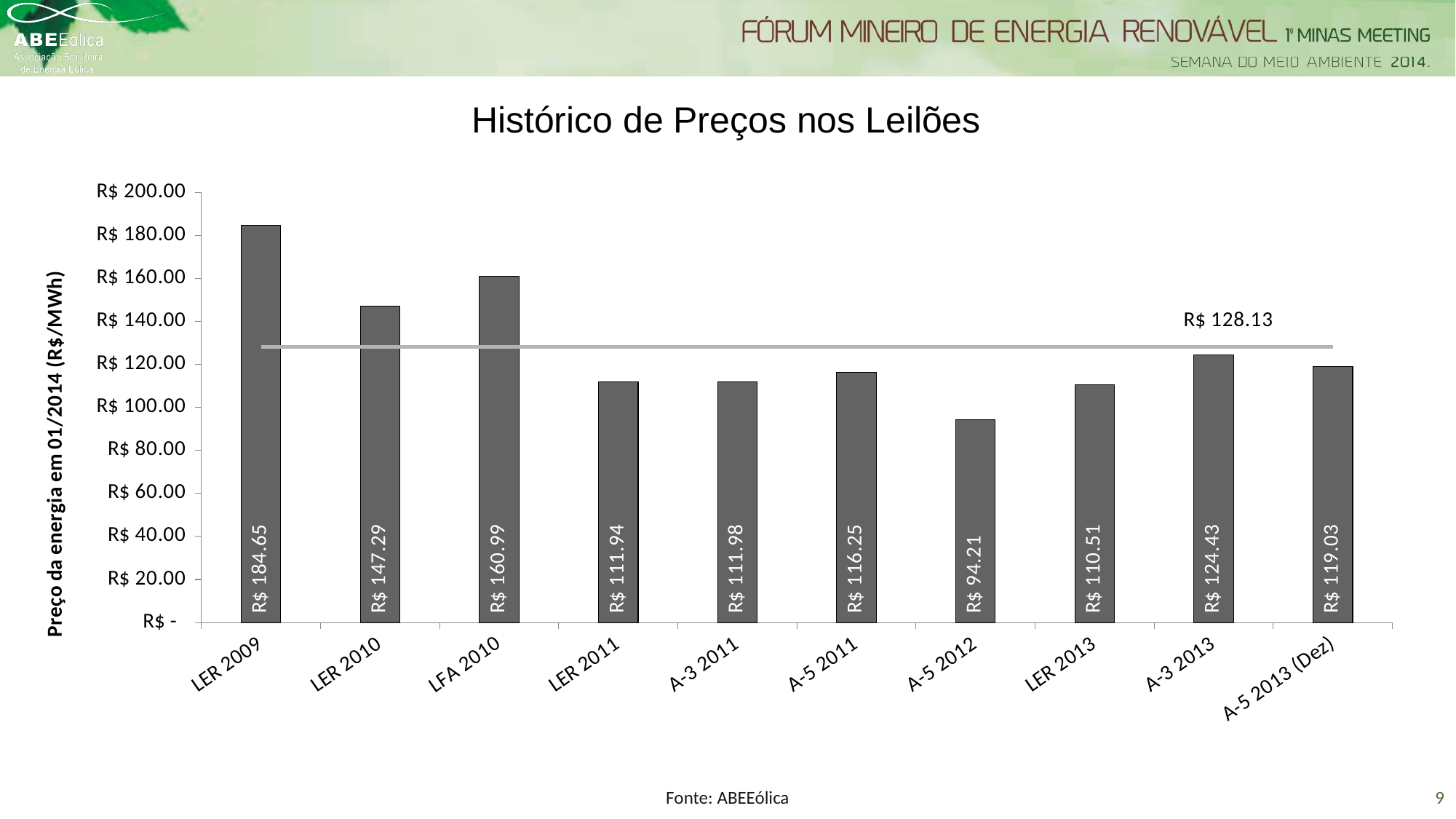
What value is labelled on the horizontal line across the chart? R$ 128.13 What is the value for A-5 2012? R$ 94.21 Which is larger, the value for LFA 2010 or the value for A-3 2013? LFA 2010 What kind of chart is this? bar chart Which auction has the highest price? LER 2009 Which auction has the lowest price? A-5 2012 What is the title of the chart? Histórico de Preços nos Leilões How many auctions are shown on the x axis? 10 What is the value for A-5 2013 (Dez)? R$ 119.03 What is the difference between the values for LER 2009 and LER 2010? R$ 37.36 What is the value for LER 2009? R$ 184.65 Is the value for LER 2013 greater or less than R$ 120.00? less